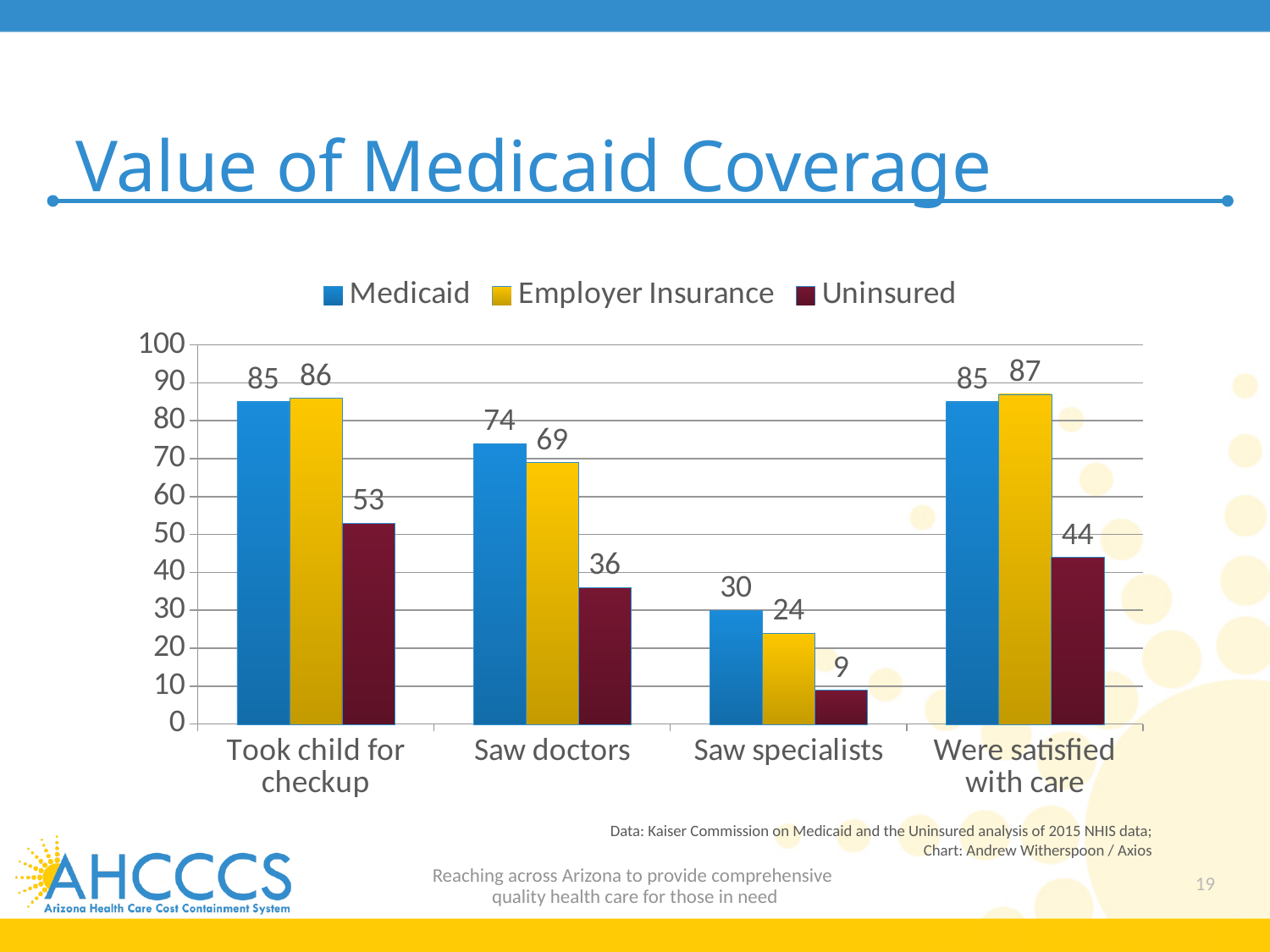
What is the difference between the Employer Insurance and Medicaid values for Saw specialists? 6 Which is larger for Took child for checkup: the Medicaid value or the Uninsured value? Medicaid What is the difference between the Medicaid and Uninsured values for Saw doctors? 38 What is the Uninsured value for Saw specialists? 9 Which category has the lowest Uninsured value? Saw specialists What kind of chart is shown on the slide? Bar chart What is the Medicaid value for Saw doctors? 74 Which series is shown in yellow in the legend? Employer Insurance How many categories are shown on the x axis? 4 How many series does the legend list? 3 What is the Employer Insurance value for Were satisfied with care? 87 Which category has the highest Employer Insurance value? Were satisfied with care